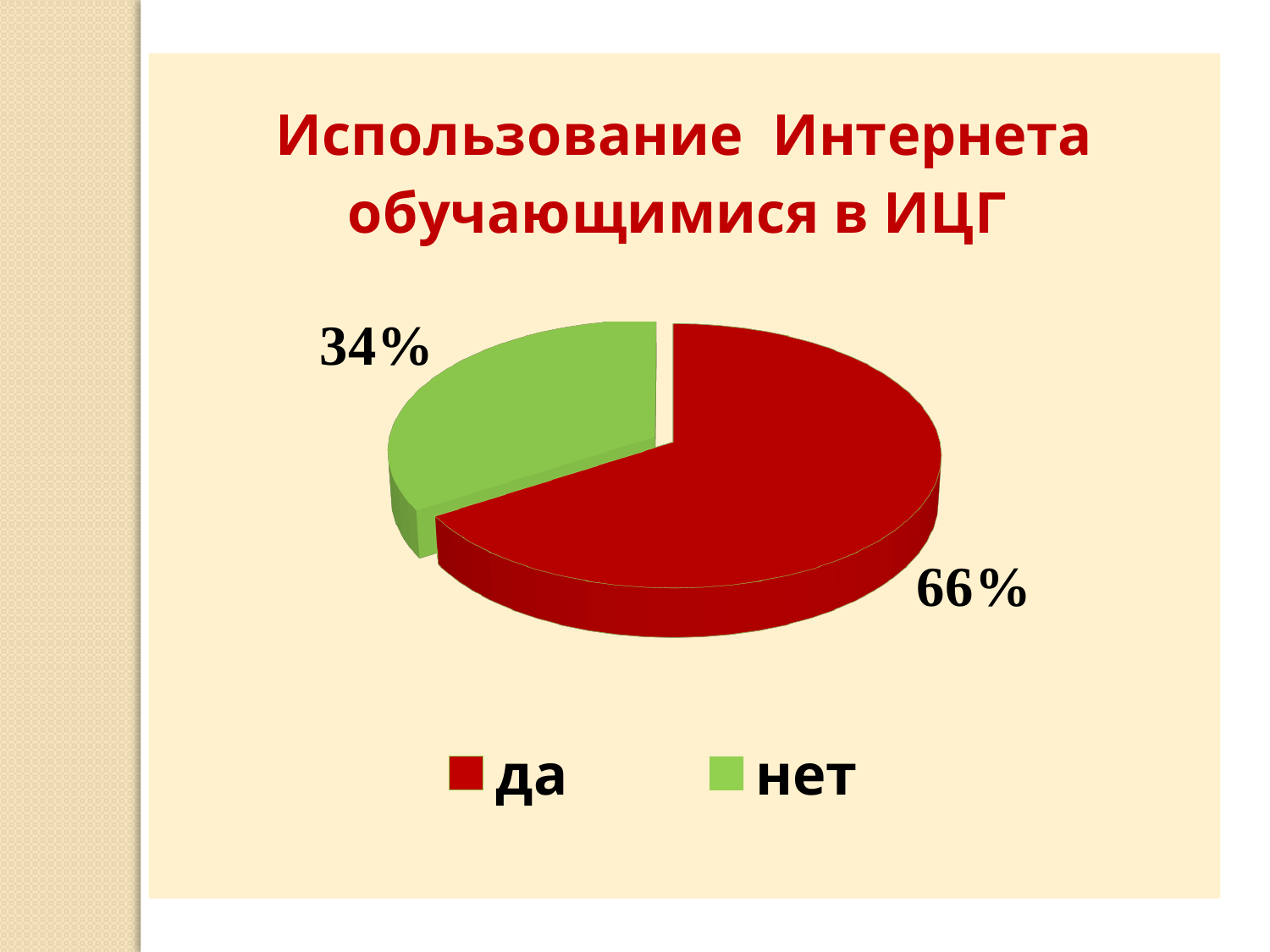
What kind of chart is shown on the slide? pie chart What share of the pie does the "нет" slice represent? 34% Which slice is the smallest in the pie chart? нет What is the title of the chart? Использование Интернета обучающимися в ИЦГ Which slice is the largest in the pie chart? да What colour is the "нет" slice in the pie chart? green What is the difference in percentage points between the "да" and "нет" slices? 32 Which is larger, the "да" slice or the "нет" slice? да What is the total of the two slice percentages shown? 100% How many slices does the pie chart have? 2 What share of the pie does the "да" slice represent? 66%